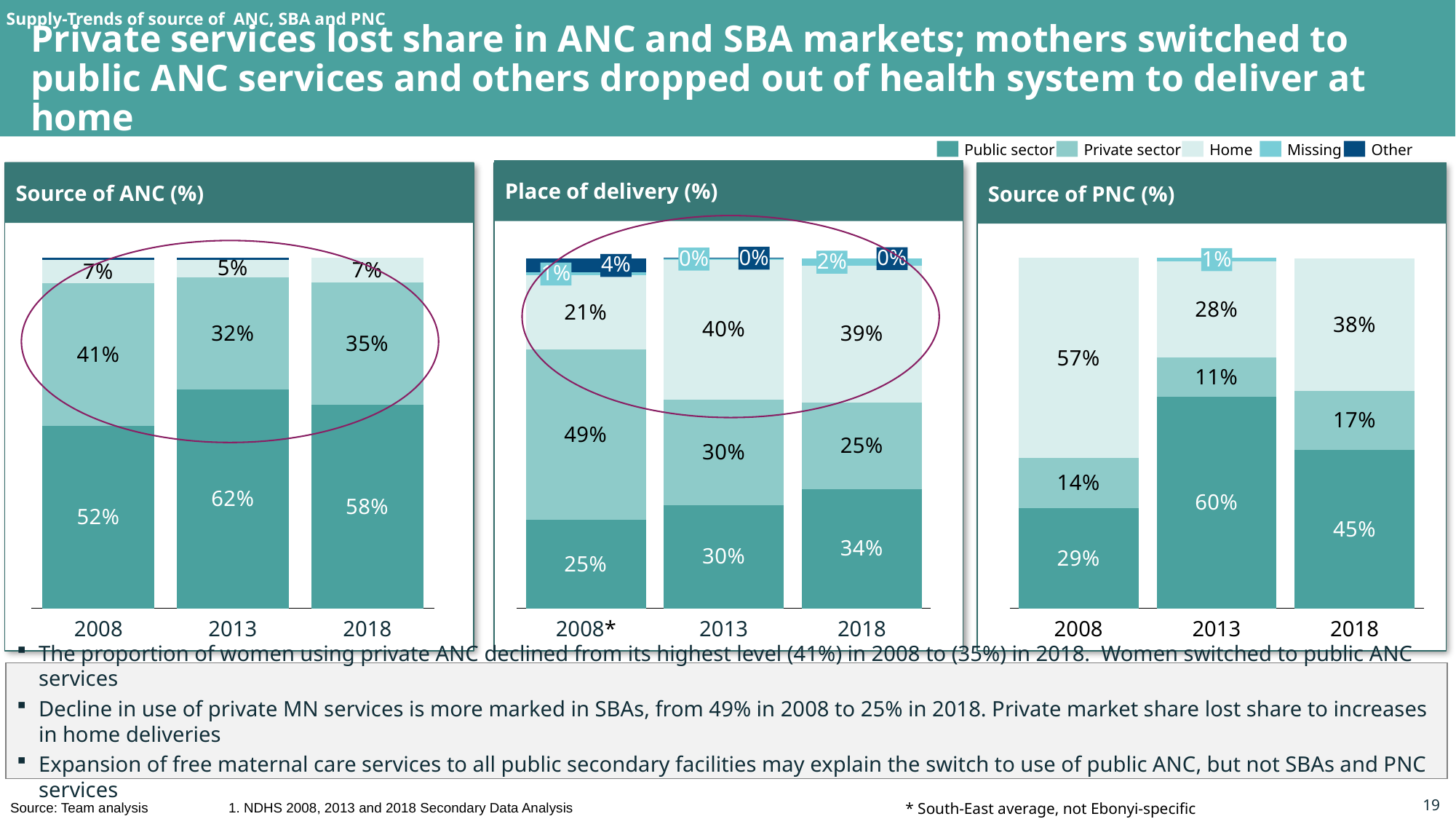
In the Source of PNC (%) chart, what is the Home value for 2008? 57% In the Source of PNC (%) chart, which year has the highest public sector value? 2013 In the Place of delivery (%) chart, which year has the lowest public sector value? 2008* In the Source of ANC (%) chart, what is the public sector value for 2013? 62% In the Place of delivery (%) chart, what is the private sector value for 2018? 25% In the Source of PNC (%) chart, is the private sector value larger in 2018 or in 2013? 2018 In the Source of ANC (%) chart, what is the private sector value for 2008? 41% In the Place of delivery (%) chart, what is the difference between the private sector value in 2008* and in 2018? 24% In the Place of delivery (%) chart, what is the Home value for 2013? 40% What kind of chart is the Source of ANC (%) chart? Stacked bar chart In the Source of ANC (%) chart, how many years are shown on the x axis? 3 How many series does the legend list? 5